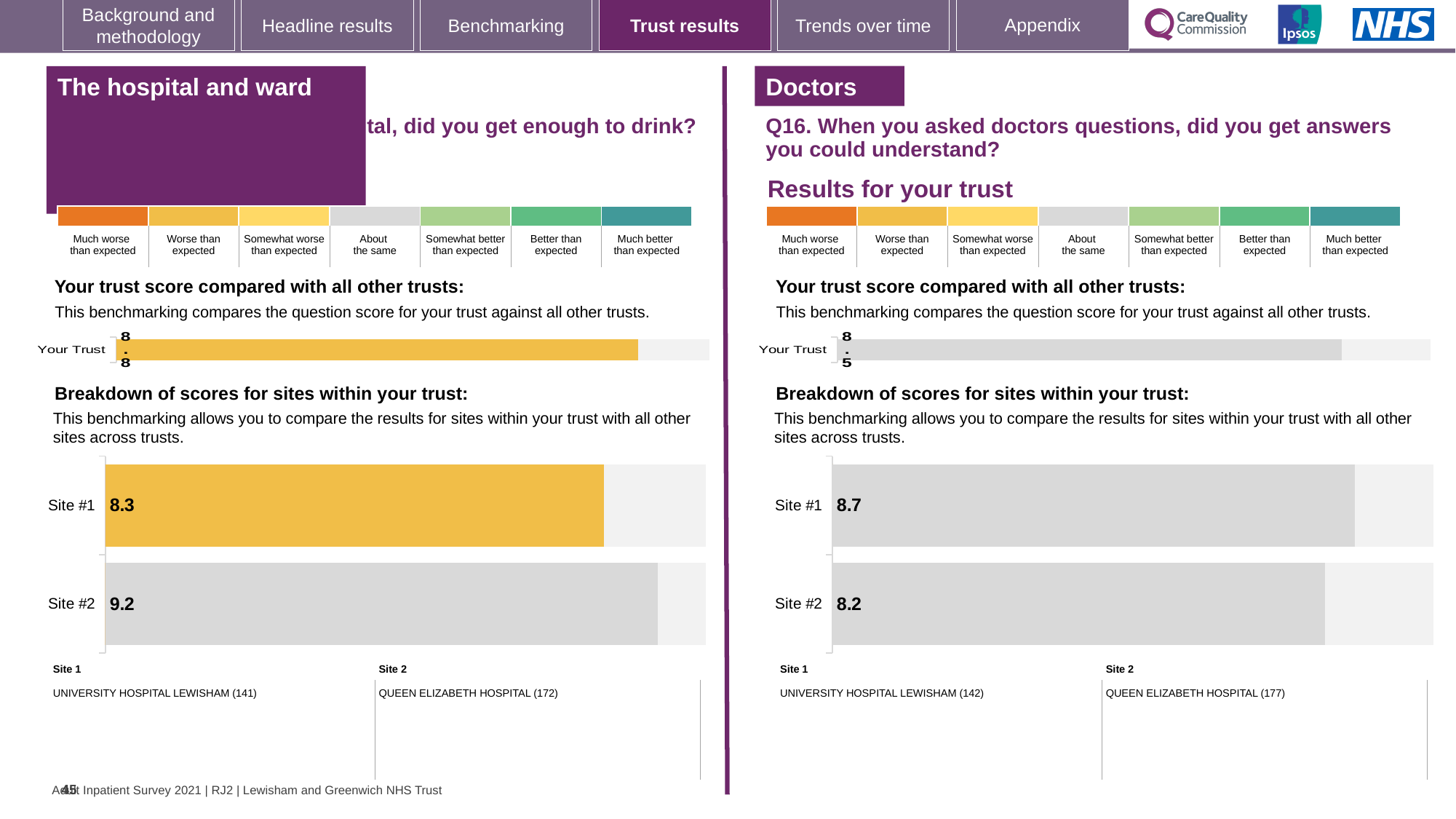
In the site breakdown chart on the right-hand side of the slide (Q16, Doctors), which site has the lower score? Site #2 In the site breakdown chart on the right-hand side of the slide (Q16, Doctors), what is the score for Site #2? 8.2 In the 'Your Trust' chart on the right-hand side of the slide (Q16, Doctors), what is the trust score? 8.5 How many sites are shown in the site breakdown chart on the left-hand side of the slide? 2 In the site breakdown chart on the left-hand side of the slide, what is the score for Site #1? 8.3 In the site breakdown chart on the left-hand side of the slide, what is the difference between the Site #2 and Site #1 scores? 0.9 In the site breakdown chart on the right-hand side of the slide (Q16, Doctors), what is the score for Site #1? 8.7 What type of chart is used for the site breakdown on the right-hand side of the slide (Q16, Doctors)? Bar chart In the site breakdown chart on the left-hand side of the slide, which site has the higher score? Site #2 In the 'Your Trust' chart on the left-hand side of the slide, what is the trust score? 8.8 In the site breakdown chart on the left-hand side of the slide, what is the score for Site #2? 9.2 In the site breakdown chart on the right-hand side of the slide (Q16, Doctors), what is the difference between the Site #1 and Site #2 scores? 0.5